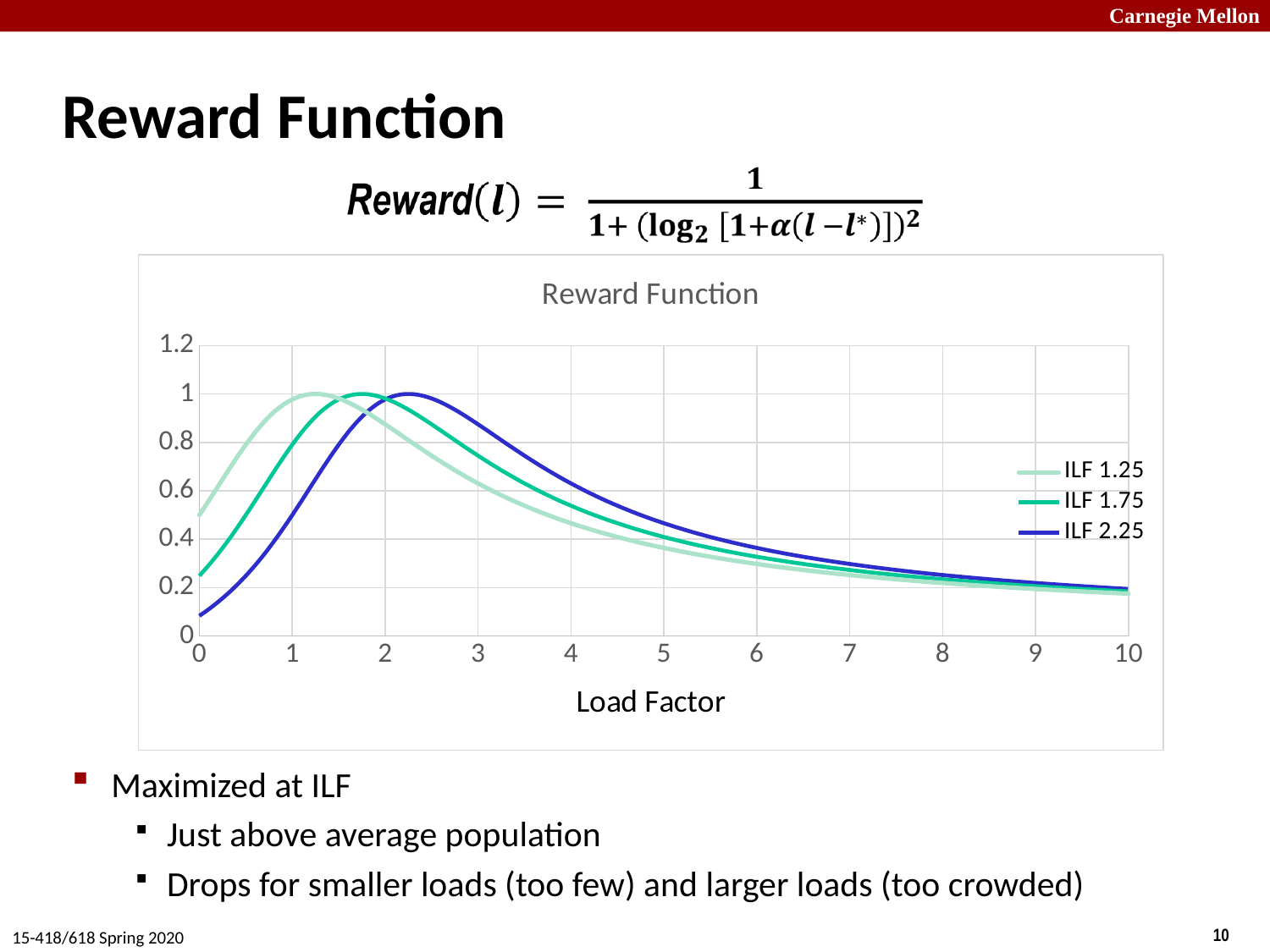
What is the label of the x axis of the chart? Load Factor Is the value of the ILF 2.25 curve at load factor 0 greater or less than 0.2? less Which series reaches its peak at the largest load factor? ILF 2.25 What is the title of the chart? Reward Function Is the value of the ILF 1.75 curve at load factor 10 greater or less than 0.4? less What is the maximum value reached by the ILF 1.75 curve? 1 At load factor 5, which curve has the higher value, ILF 1.25 or ILF 2.25? ILF 2.25 After reaching its peak, does the ILF 1.25 curve rise or fall as the load factor increases toward 10? fall What kind of chart is shown on the slide? line chart Is the value of the ILF 1.25 curve at load factor 0 greater or less than 0.4? greater At load factor 0, which curve has the higher value, ILF 1.25 or ILF 2.25? ILF 1.25 How many series does the chart legend list? 3